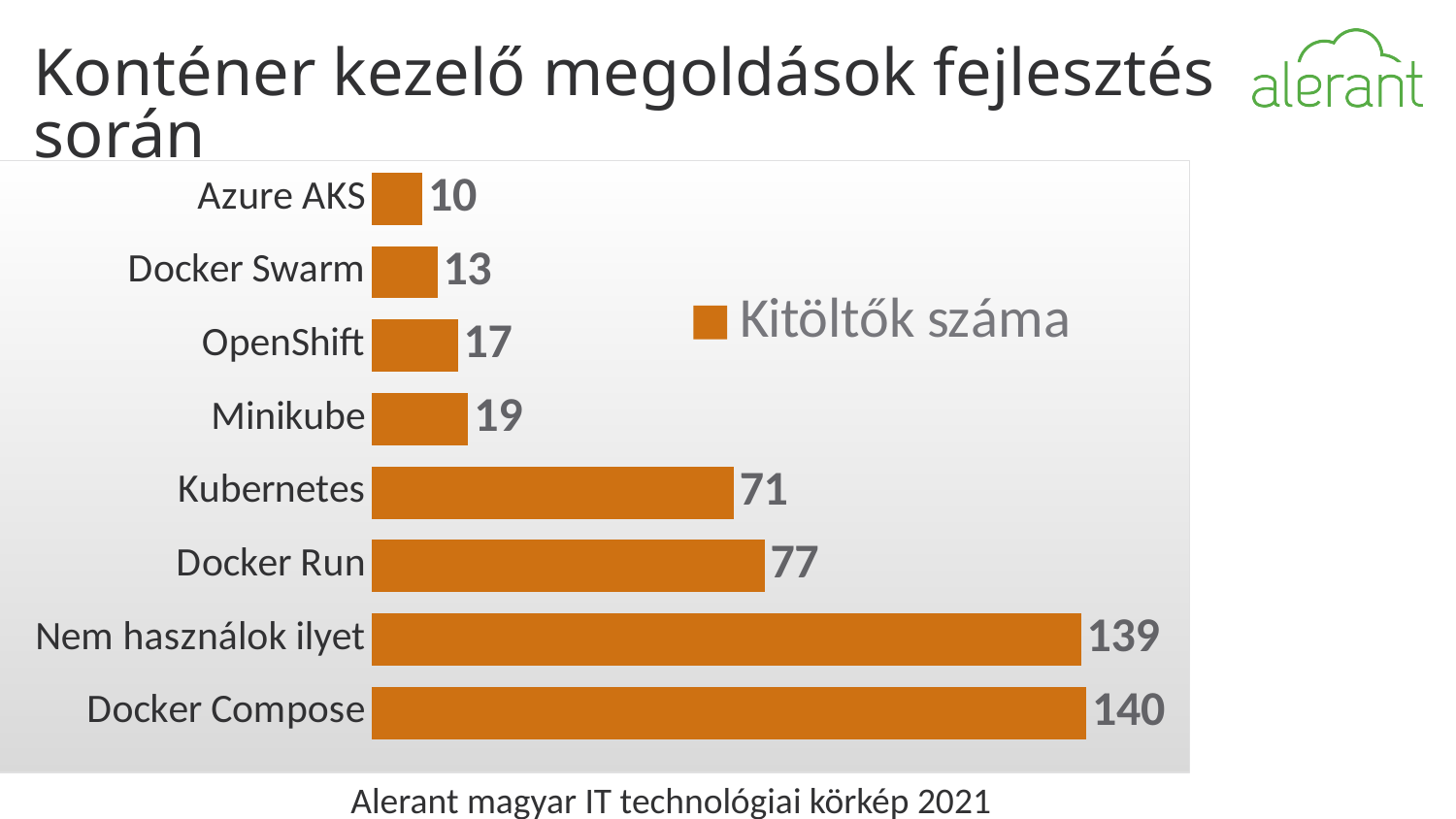
How many series does the legend list? 1 What is the value for Docker Compose? 140 What is the difference between the values for Docker Run and Kubernetes? 6 What is the value for OpenShift? 17 Which category has the lowest value? Azure AKS What is the difference between the values for Minikube and Docker Swarm? 6 How many categories are shown in the chart? 8 What is the value for Nem használok ilyet? 139 What kind of chart is shown on the slide? bar chart What is the value for Kubernetes? 71 Which is larger, the value for Docker Run or the value for Minikube? Docker Run What is the legend entry shown in the chart? Kitöltők száma